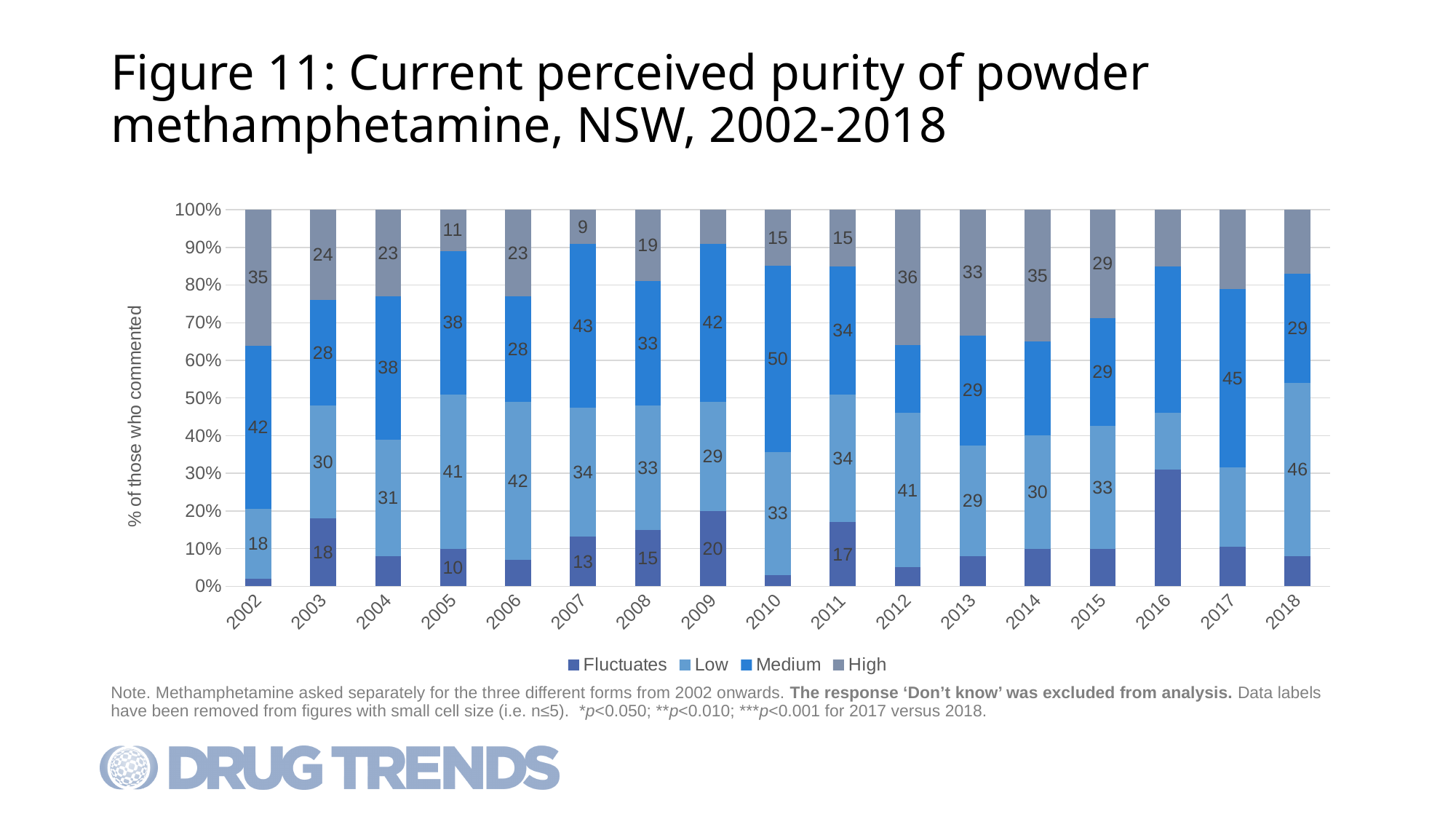
What are the four legend entries? Fluctuates, Low, Medium, High What is the difference between the Low and Fluctuates values in 2003? 12 In 2007, which is larger: Medium or Low? Medium Is the value for Fluctuates in 2016 greater or less than 20%? greater What is the value for Fluctuates in 2009? 20 What is the value for High in 2002? 35 What is the value for Low in 2018? 46 What is the value for Medium in 2010? 50 In which year is the Medium value highest? 2010 How many series does the legend list? 4 What kind of chart is shown on the slide? Stacked bar chart How many years are shown along the x axis? 17